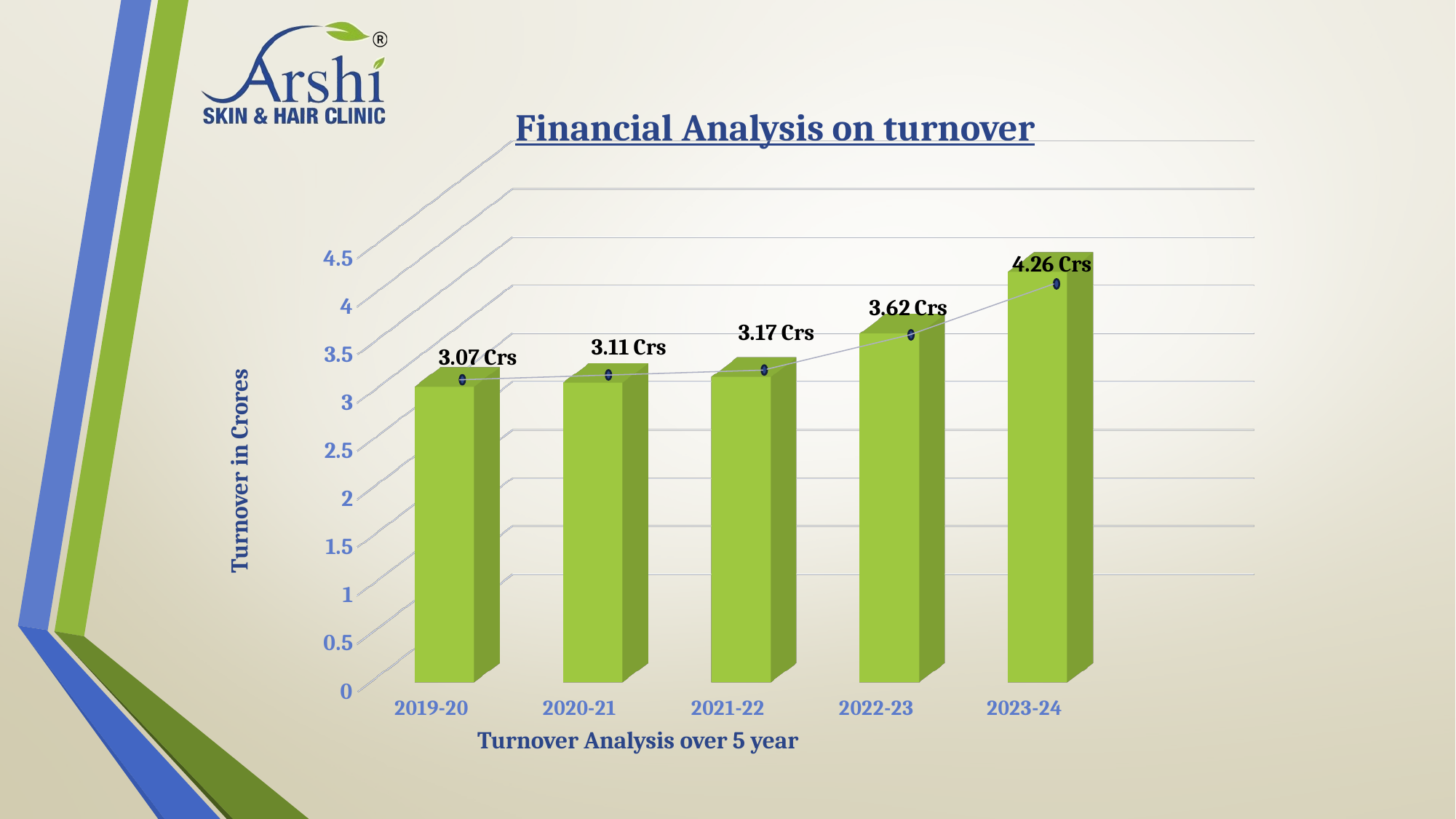
What is the turnover for 2022-23? 3.62 Crs Is the turnover for 2023-24 greater or less than 4? greater How many years are shown on the chart? 5 What is the turnover for 2023-24? 4.26 Crs Which year has the highest turnover? 2023-24 What is the difference in turnover between 2021-22 and 2020-21? 0.06 Crs What is the difference in turnover between 2023-24 and 2022-23? 0.64 Crs Which year has the lowest turnover? 2019-20 Which year has a larger turnover, 2022-23 or 2021-22? 2022-23 Does the turnover rise or fall from 2019-20 to 2023-24? Rise What kind of chart is shown on the slide? Bar chart What is the turnover for 2019-20? 3.07 Crs